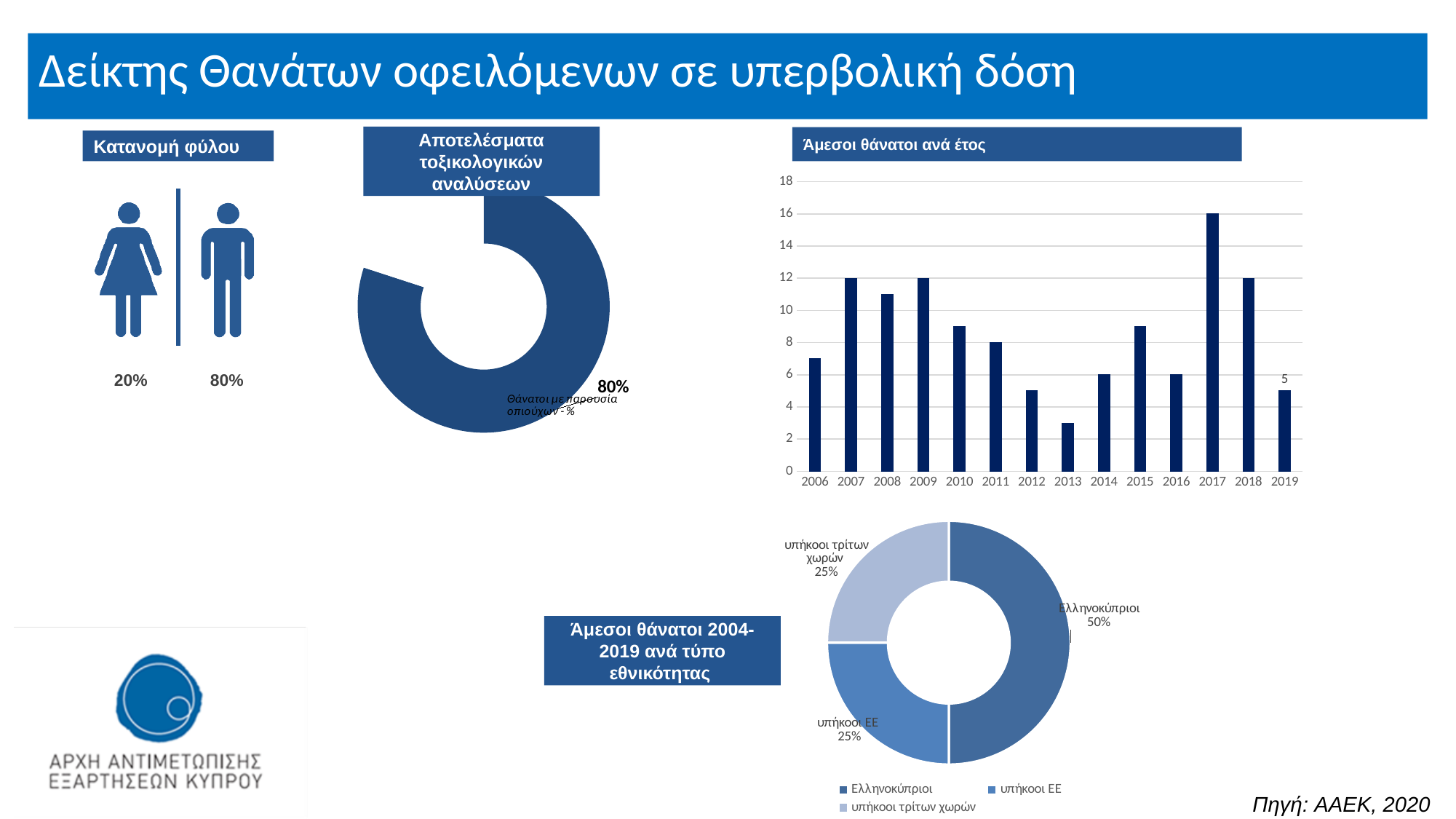
In the chart 'Άμεσοι θάνατοι ανά έτος', is the value for 2010 greater or less than 8? greater In the chart 'Άμεσοι θάνατοι ανά έτος', is the value for 2013 greater or less than 4? less In the chart 'Άμεσοι θάνατοι 2004-2019 ανά τύπο εθνικότητας', what share is 'Ελληνοκύπριοι'? 50% What kind of chart is 'Άμεσοι θάνατοι ανά έτος'? bar chart In the chart 'Άμεσοι θάνατοι ανά έτος', which year has the lowest value? 2013 In the chart 'Άμεσοι θάνατοι ανά έτος', which year has the highest value? 2017 How many years are shown on the x axis of the chart 'Άμεσοι θάνατοι ανά έτος'? 14 In the chart 'Άμεσοι θάνατοι ανά έτος', which is larger, the value for 2008 or the value for 2012? 2008 In the chart 'Άμεσοι θάνατοι 2004-2019 ανά τύπο εθνικότητας', what is the value for 'υπήκοοι ΕΕ'? 25% In the chart 'Άμεσοι θάνατοι ανά έτος', what is the value for 2019? 5 How many entries does the legend of the chart 'Άμεσοι θάνατοι 2004-2019 ανά τύπο εθνικότητας' list? 3 In the chart 'Άμεσοι θάνατοι ανά έτος', what is the value for 2017? 16